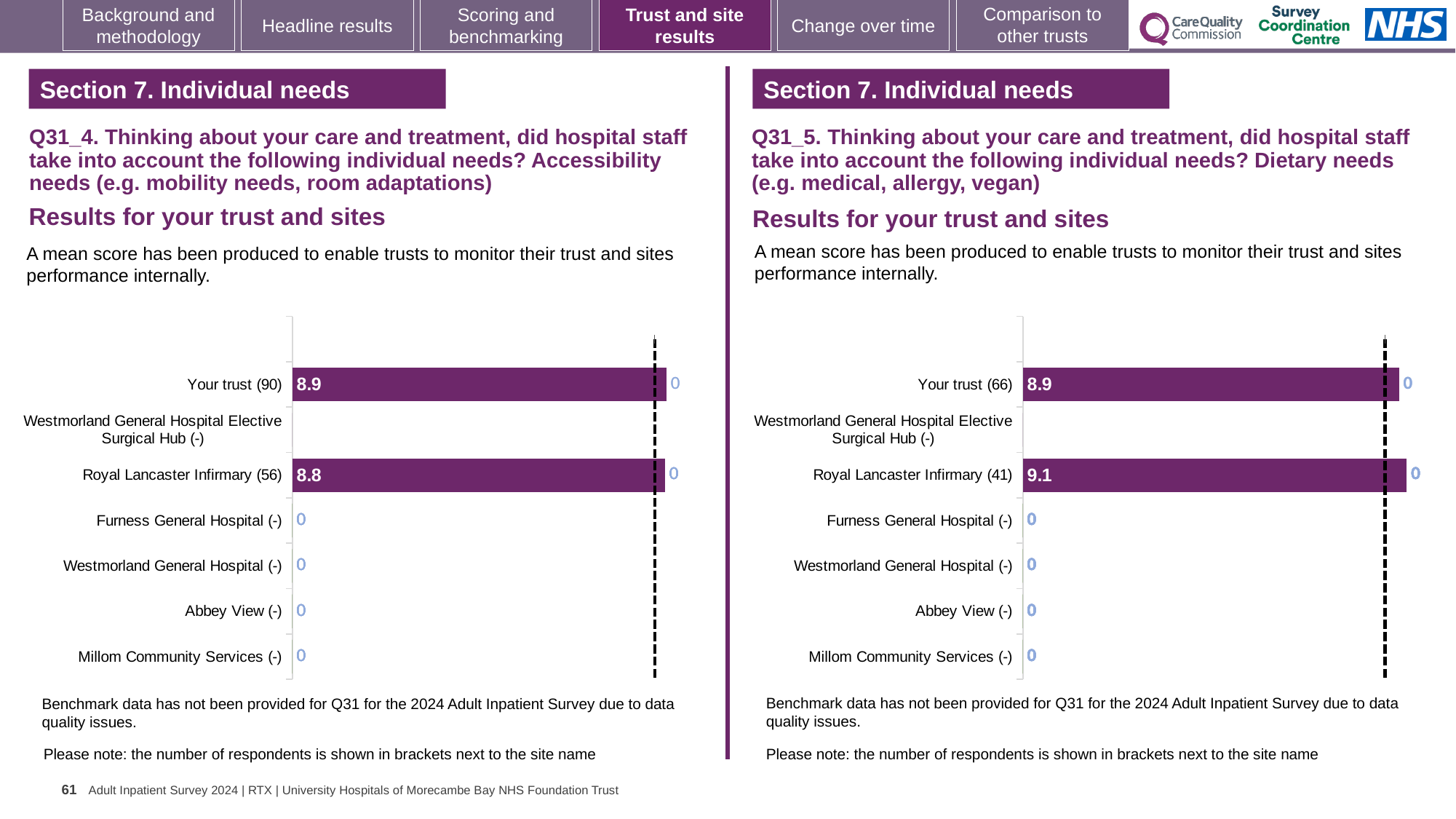
On the left chart (Q31_4, Accessibility needs), what is the mean score for Royal Lancaster Infirmary? 8.8 On the right chart (Q31_5, Dietary needs), what is the mean score for Your trust? 8.9 On the left chart (Q31_4, Accessibility needs), what is the difference between the Your trust score and the Royal Lancaster Infirmary score? 0.1 On the left chart (Q31_4, Accessibility needs), which is higher: Your trust or Royal Lancaster Infirmary? Your trust On the right chart (Q31_5, Dietary needs), what is the mean score for Royal Lancaster Infirmary? 9.1 On the right chart (Q31_5, Dietary needs), what is the difference between the Royal Lancaster Infirmary score and the Your trust score? 0.2 On the left chart (Q31_4, Accessibility needs), what is the mean score for Your trust? 8.9 What type of chart is used on the right side of the slide (Q31_5, Dietary needs)? Bar chart On the right chart (Q31_5, Dietary needs), which is higher: Your trust or Royal Lancaster Infirmary? Royal Lancaster Infirmary On the left chart (Q31_4, Accessibility needs), how many respondents are shown in brackets for Your trust? 90 On the right chart (Q31_5, Dietary needs), how many respondents are shown in brackets for Royal Lancaster Infirmary? 41 How many categories are listed on the y axis of the left chart (Q31_4, Accessibility needs)? 7